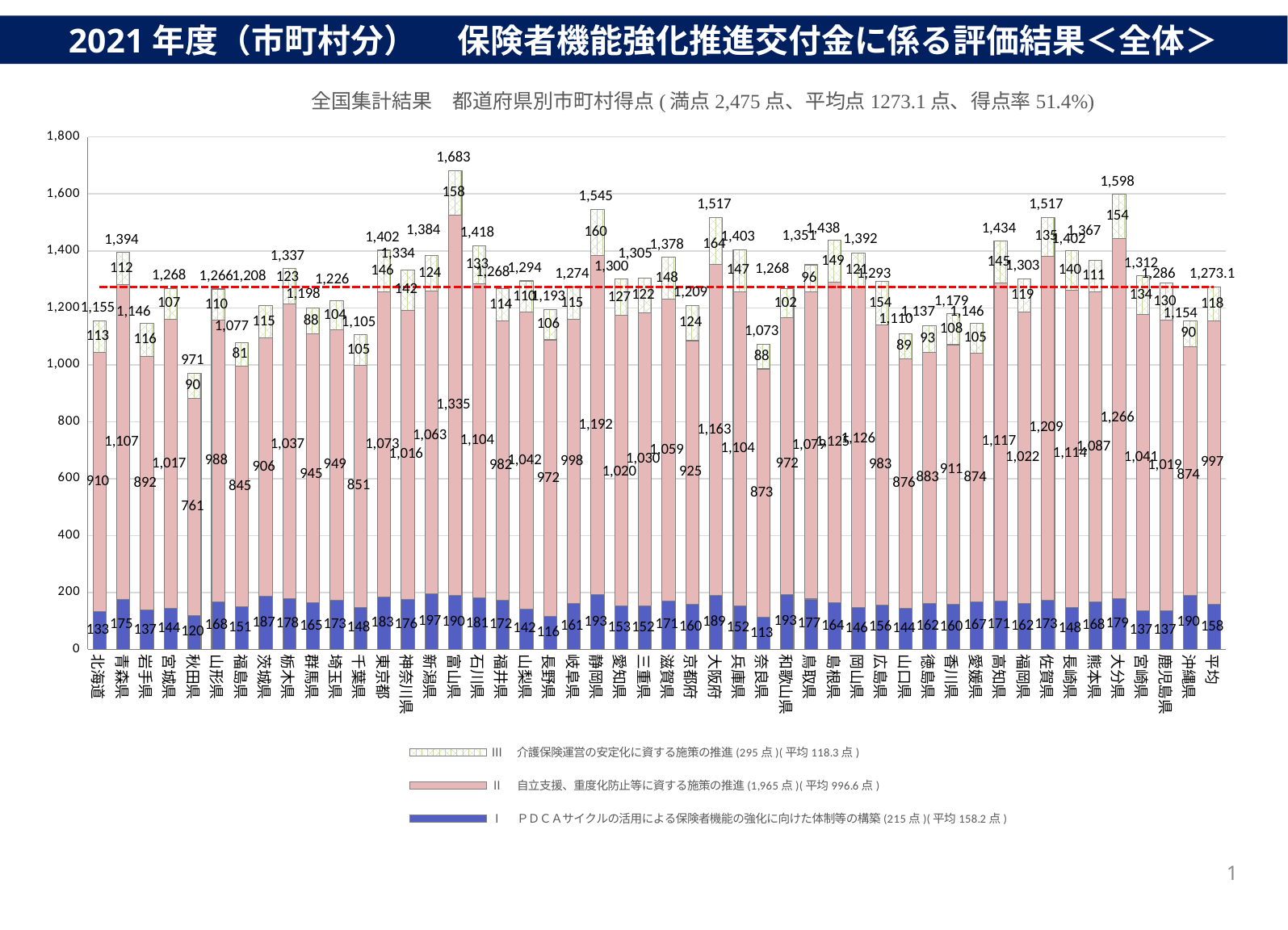
Is the total score for 秋田県 greater or less than 1,000? less What value does the red dashed horizontal line represent? 1,273.1 (平均点) Which prefecture has the lowest total score? 秋田県 (971) What is the difference between the total score of 富山県 and that of 秋田県? 712 What kind of chart is shown on the slide? Stacked bar chart Which prefecture has the highest total score? 富山県 (1,683) What is the value of series I (ＰＤＣＡサイクル) for 新潟県? 197 What is the total score for 東京都? 1,402 Which has the larger total score, 静岡県 or 大分県? 大分県 What is the value of series II (自立支援、重度化防止等に資する施策の推進) for 富山県? 1,335 What is the value of series III (介護保険運営の安定化) for 大阪府? 164 How many series does the legend list? 3